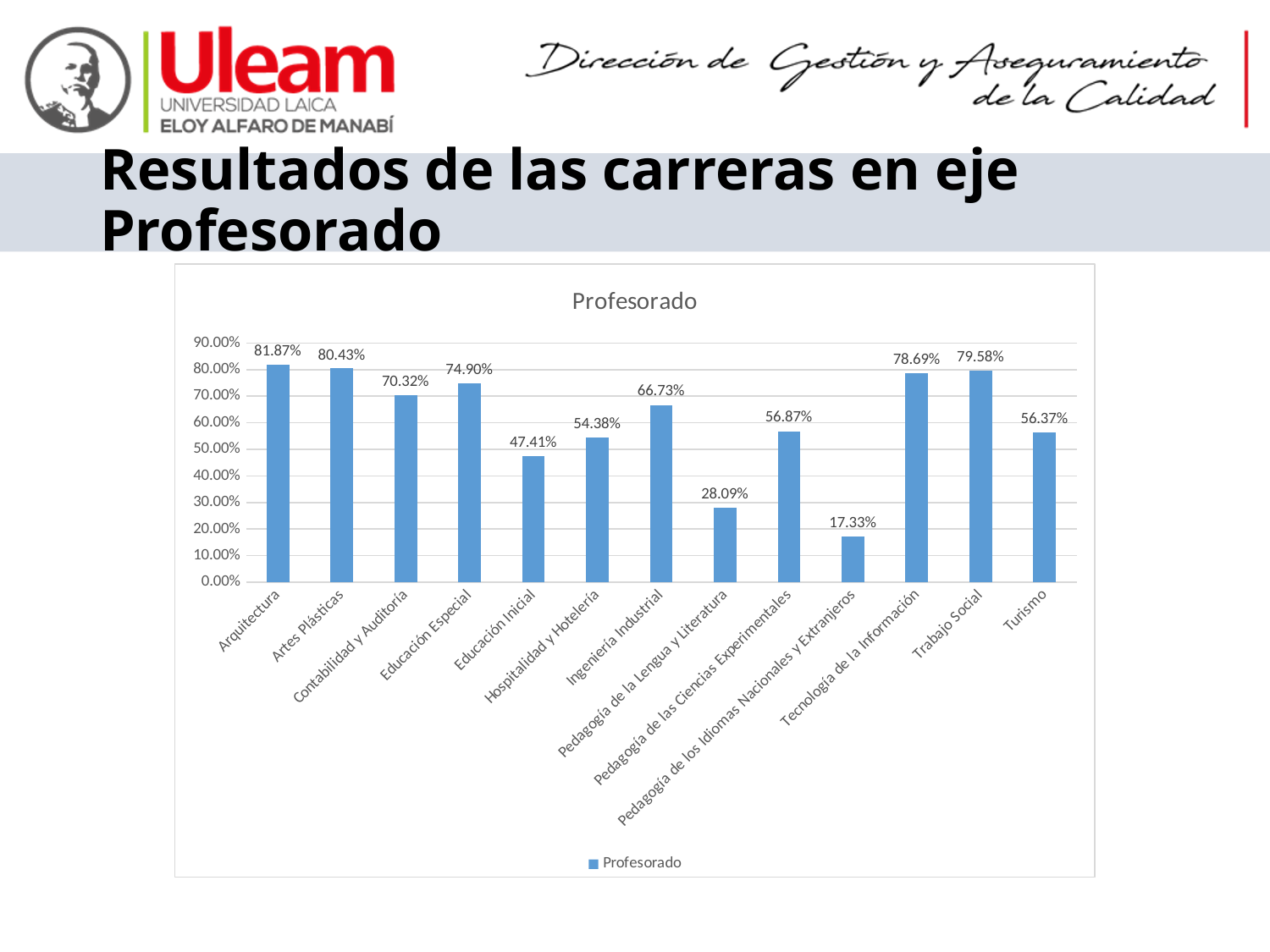
Which category has the lowest value? Pedagogía de los Idiomas Nacionales y Extranjeros What is the value for Pedagogía de la Lengua y Literatura? 28.09% What is the title of the chart? Profesorado What is the value for Arquitectura? 81.87% What kind of chart is shown? Bar chart Which is larger, the value for Hospitalidad y Hotelería or the value for Ingeniería Industrial? Ingeniería Industrial What is the difference between the values for Arquitectura and Turismo? 25.50% What is the value for Trabajo Social? 79.58% What is the difference between the values for Educación Especial and Educación Inicial? 27.49% How many categories are shown on the x axis? 13 Is the value for Contabilidad y Auditoría greater or less than 60.00%? greater Which category has the highest value? Arquitectura